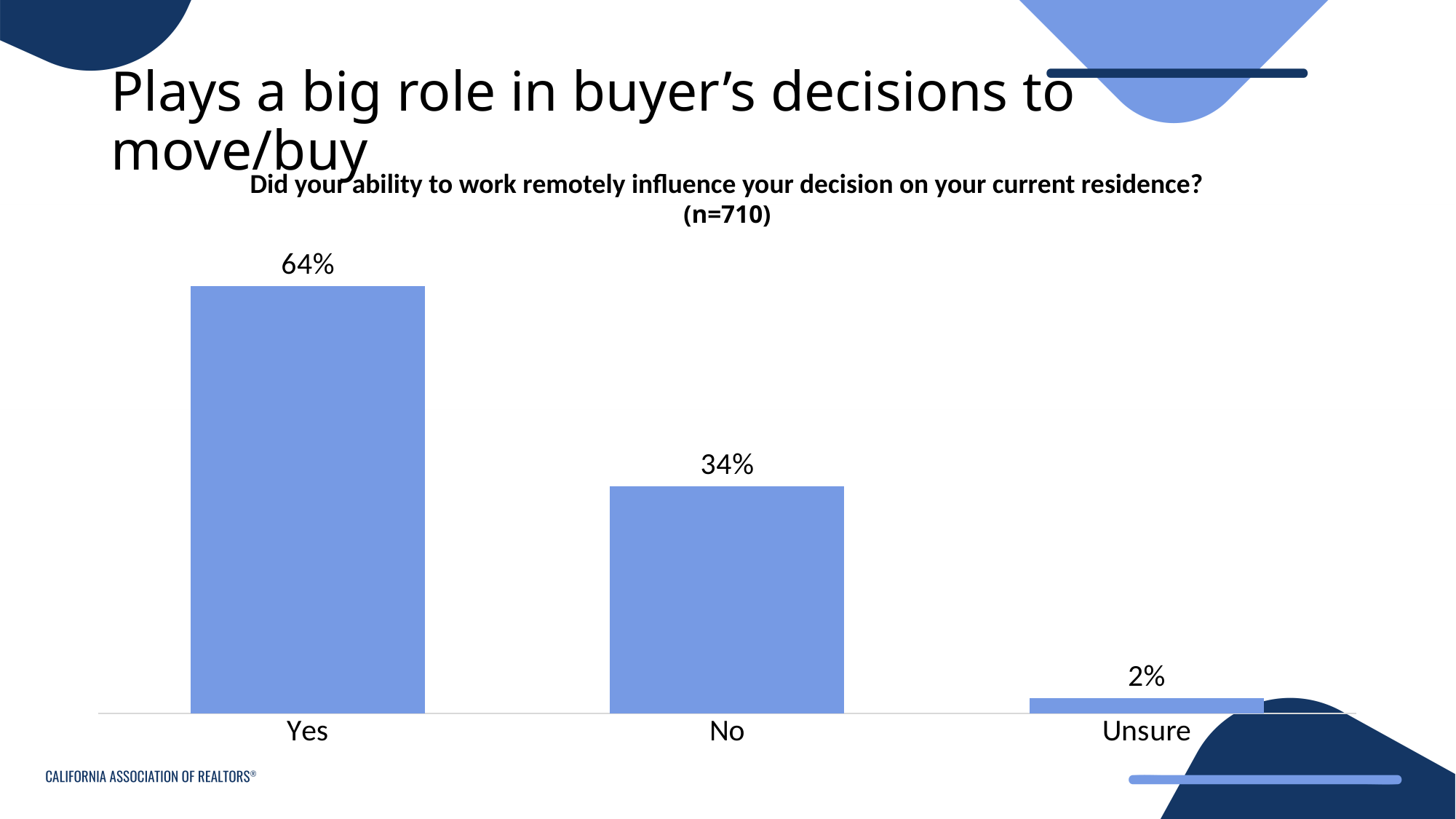
What percentage of respondents answered Unsure? 2% Which response category has the lowest value? Unsure Which is larger, the value for Yes or the value for No? Yes What is the difference in percentage points between the No and Unsure responses? 32 What percentage of respondents answered Yes? 64% What is the sample size (n) stated in the chart title? 710 How many response categories are shown in the chart? 3 What is the difference in percentage points between the Yes and No responses? 30 What kind of chart is shown on the slide? Bar chart Do the values rise or fall moving from left to right across the categories? Fall Which response category has the highest value? Yes What percentage of respondents answered No? 34%